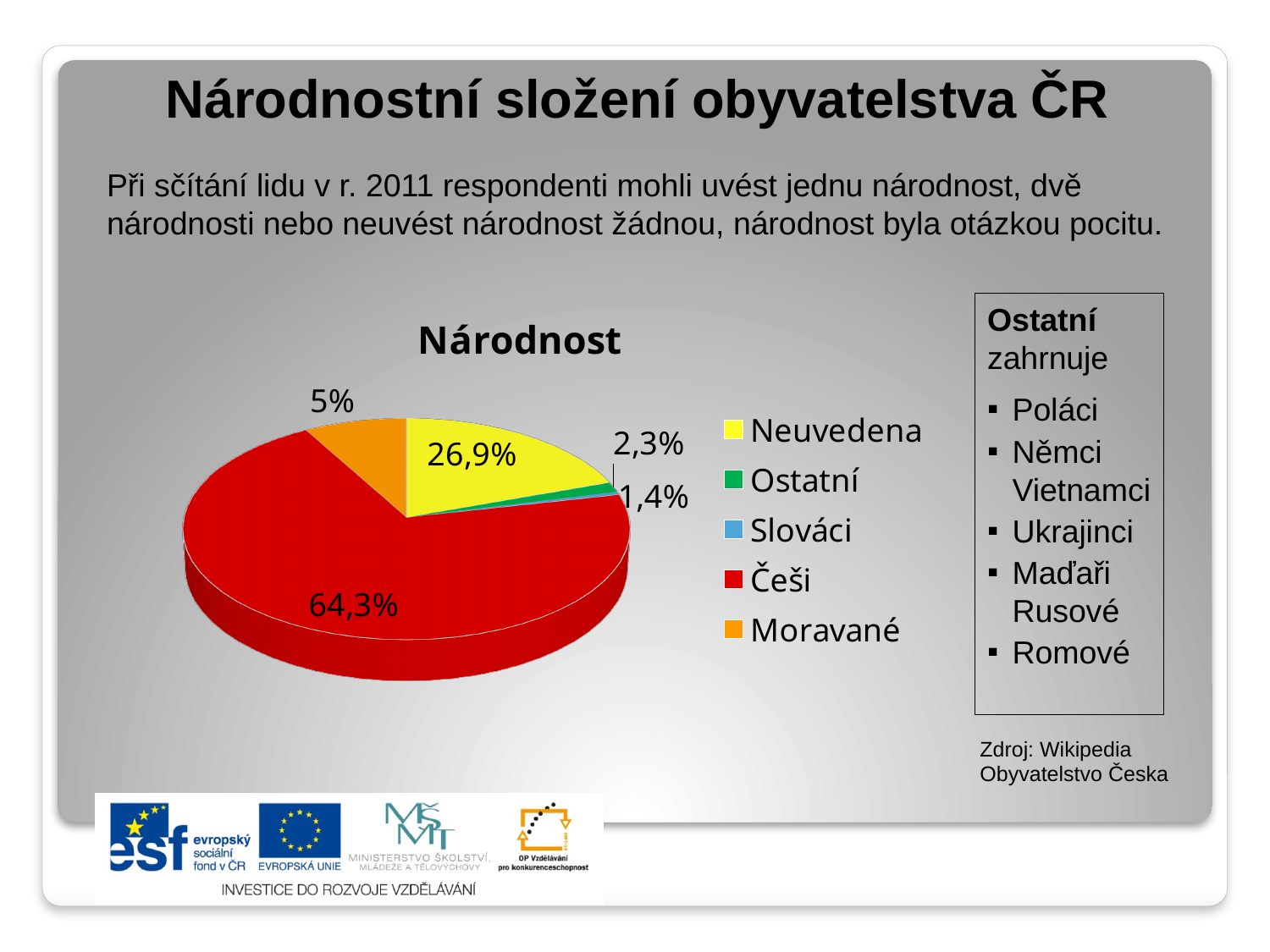
What share of the pie is Neuvedena? 26,9% How many entries does the chart legend list? 5 What is the difference in percentage points between Češi and Neuvedena? 37,4 What share of the pie is Ostatní? 2,3% What share of the pie is Slováci? 1,4% What kind of chart is shown on the slide? pie chart Which category has the largest slice of the pie? Češi How many slices does the pie chart have? 5 Which category has the smallest slice of the pie? Slováci What is the title of the chart? Národnost